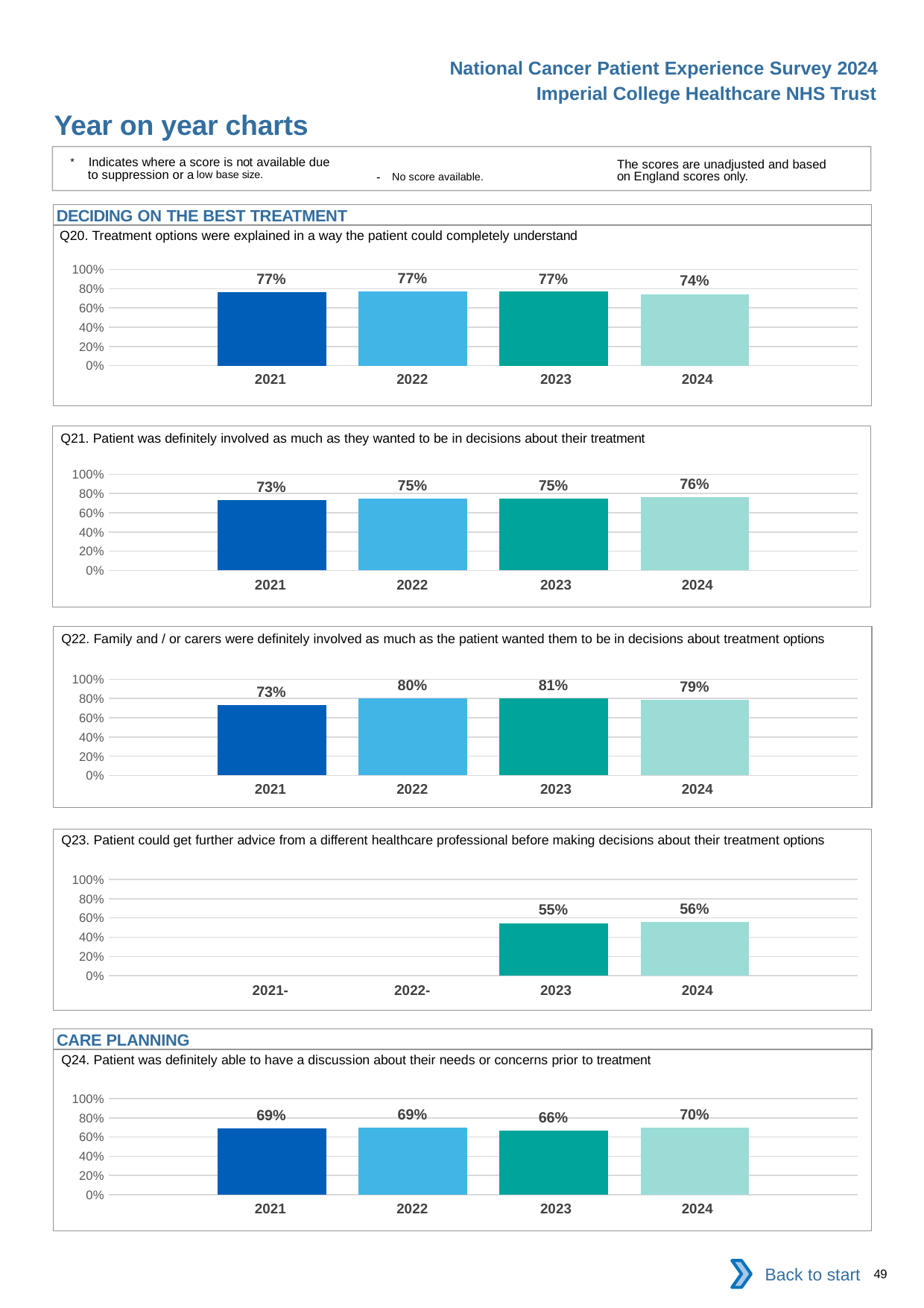
In the Q22 chart, what is the difference between the 2023 value and the 2021 value? 8% Which section heading appears above the Q24 chart? CARE PLANNING In the Q21 chart, which year has the highest value? 2024 In the Q20 chart, do the values rise or fall from 2023 to 2024? fall In the Q23 chart, how many years have a bar plotted? 2 In the Q23 chart, what is the value for 2023? 55% In the Q24 chart, which year has the lowest value? 2023 In the Q21 chart, what is the value for 2021? 73% In the Q22 chart, which year has the lowest value? 2021 In the Q20 chart, what is the value for 2024? 74% In the Q24 chart, is the value for 2024 larger or smaller than the value for 2023? larger What kind of chart is the Q21 chart? bar chart